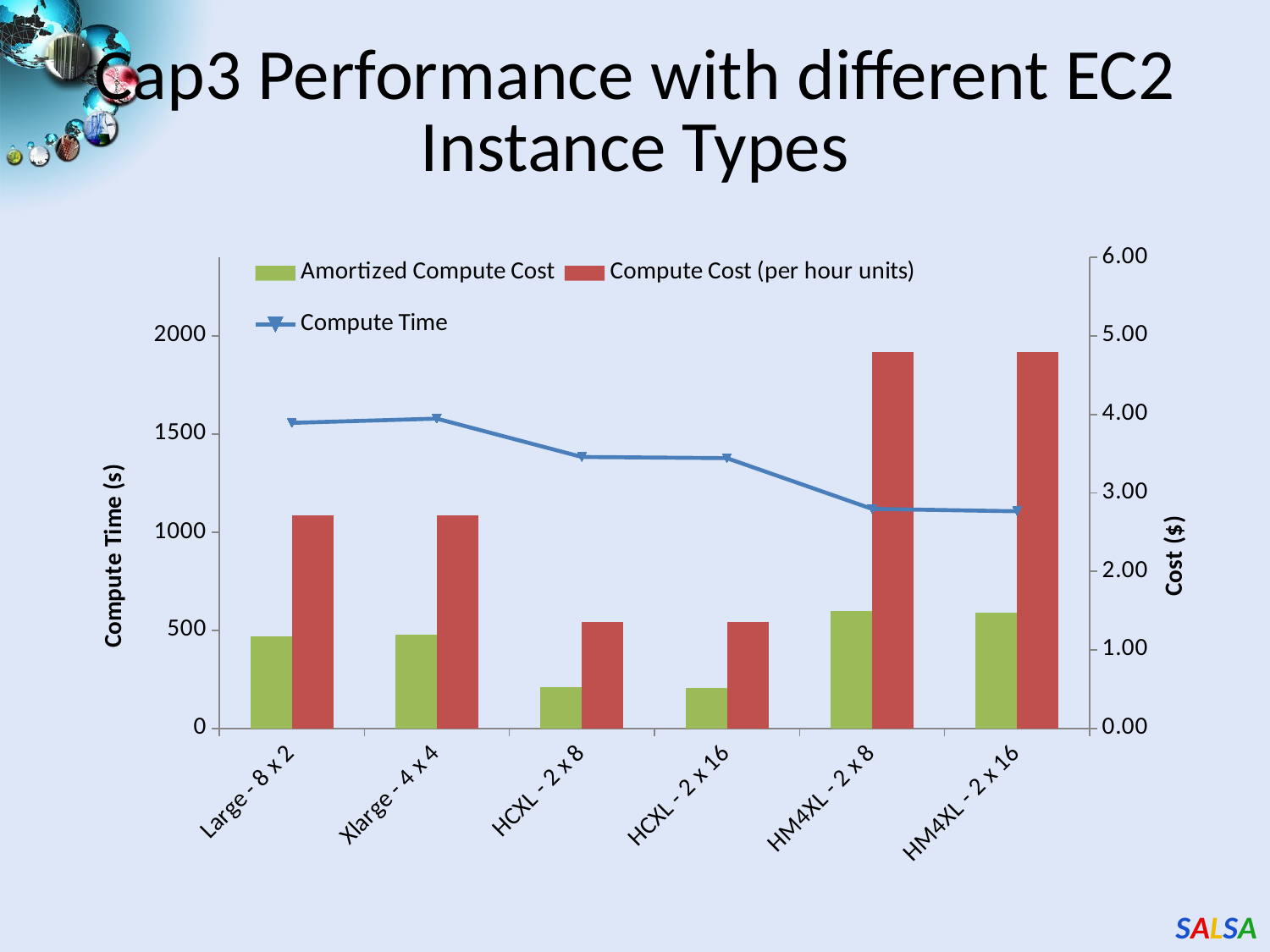
Is the Compute Cost (per hour units) for HCXL - 2 x 8 greater or less than 2.00? less Which has the larger Amortized Compute Cost: HM4XL - 2 x 8 or HCXL - 2 x 8? HM4XL - 2 x 8 What is the title of the right vertical axis of the chart? Cost ($) Is the Compute Time for HM4XL - 2 x 16 greater or less than 1500? less How many series does the chart legend list? 3 Which has the larger Compute Cost (per hour units): Large - 8 x 2 or HCXL - 2 x 8? Large - 8 x 2 How many instance types are shown on the x axis of the chart? 6 Does the Compute Time line generally rise or fall from left to right across the instance types? fall Is the Compute Time for Large - 8 x 2 greater or less than 1000? greater What is the title of the left vertical axis of the chart? Compute Time (s)